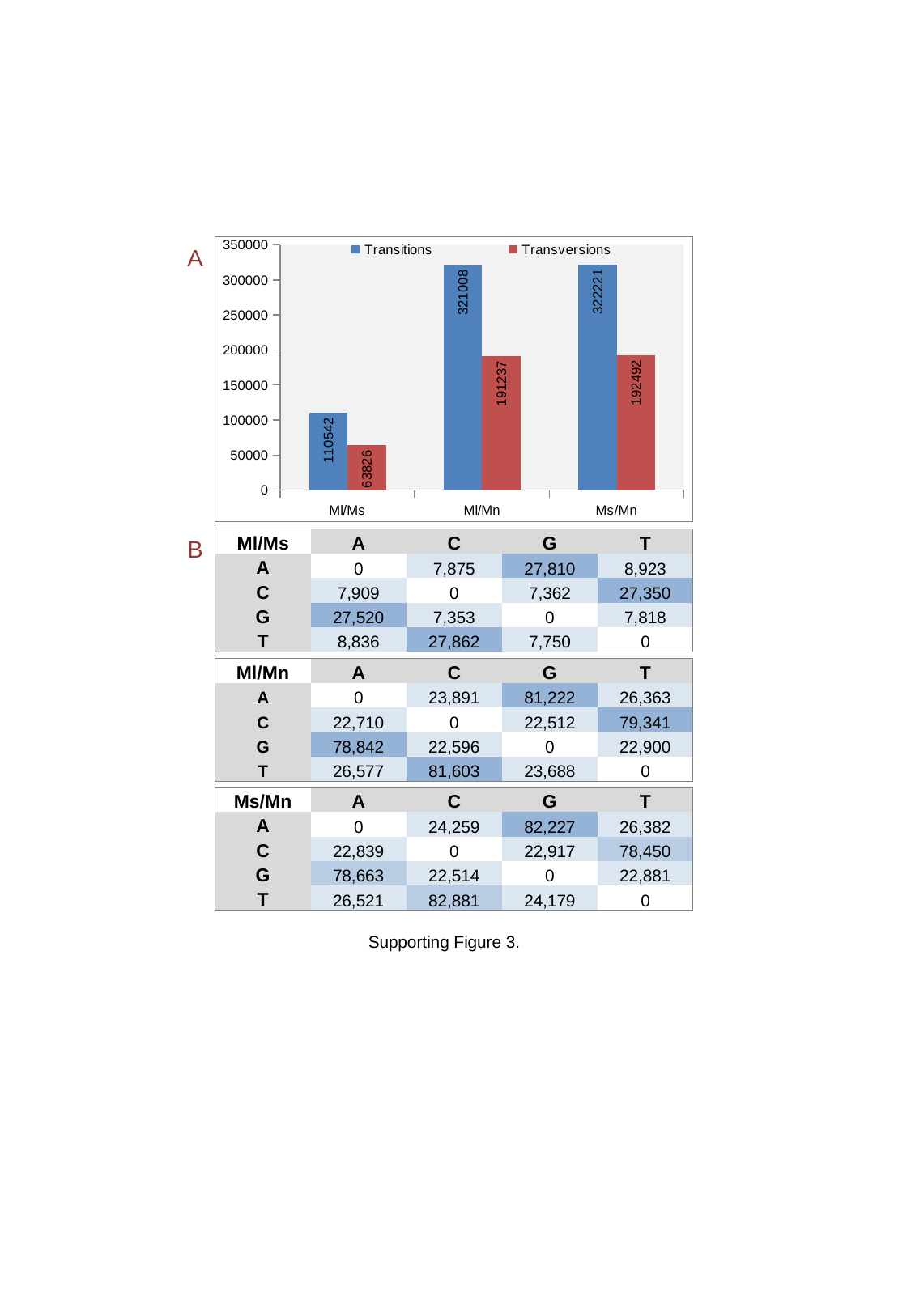
How many categories are shown on the x axis of the chart in panel A? 3 In the chart in panel A, what is the Transitions value for Ms/Mn? 322221 What type of chart is shown in panel A? bar chart In the chart in panel A, which category has the highest Transversions value? Ms/Mn In the chart in panel A, what is the Transitions value for Ml/Ms? 110542 In the chart in panel A, what is the Transversions value for Ml/Mn? 191237 In the chart in panel A, what is the Transversions value for Ms/Mn? 192492 In the chart in panel A, is the Transversions value for Ml/Ms greater or less than 100000? less In the chart in panel A, what is the difference between the Transitions and Transversions values for Ml/Ms? 46716 In the chart in panel A, which category has the lowest Transitions value? Ml/Ms In the chart in panel A, is the Transitions value for Ml/Mn larger or the Transversions value for Ml/Mn? Transitions How many series does the legend of the chart in panel A list? 2